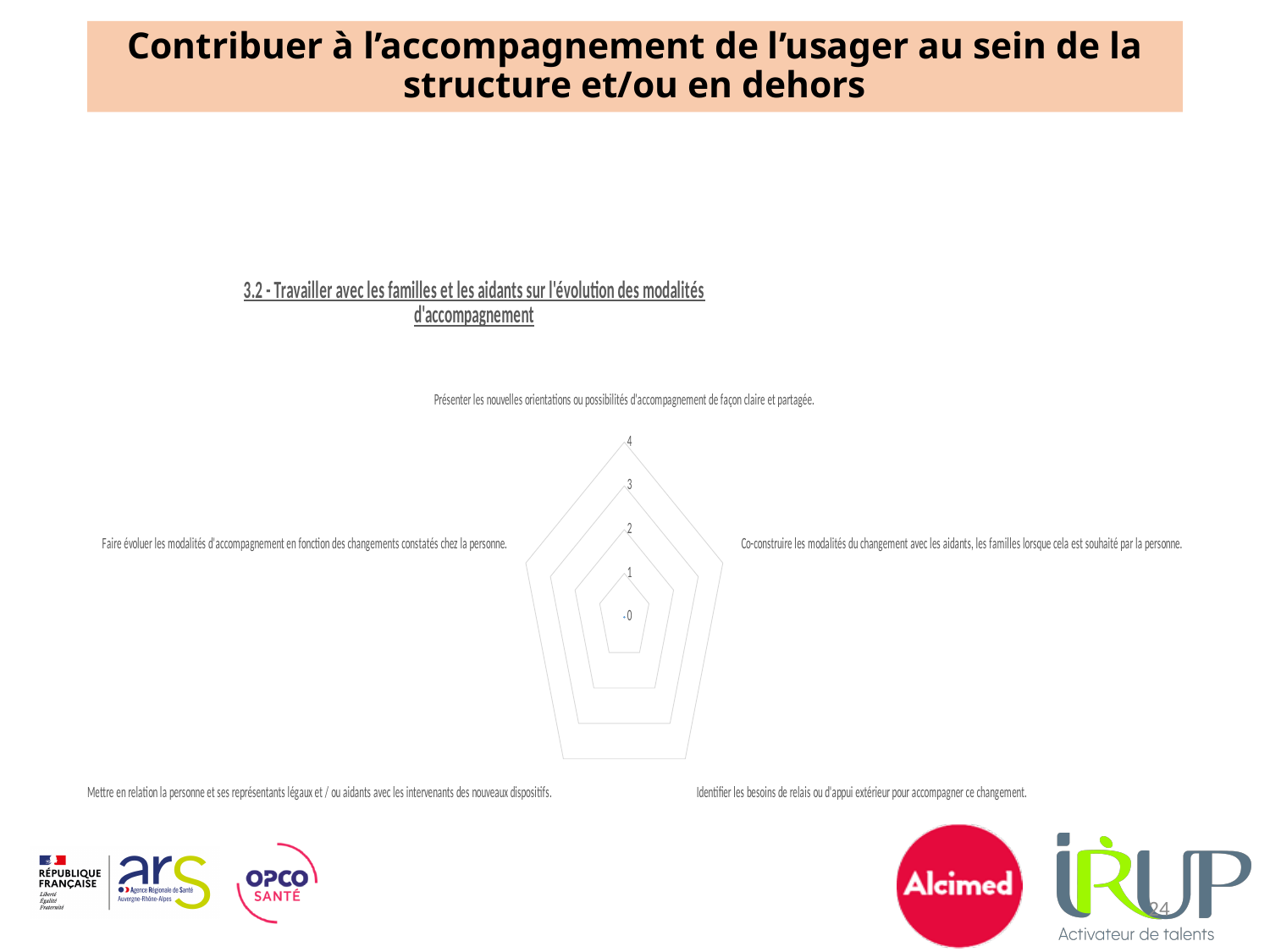
How many categories (axes) does the radar chart have? 5 What is the title of the radar chart? 3.2 - Travailler avec les familles et les aidants sur l'évolution des modalités d'accompagnement What is the highest value shown on the radar chart's scale? 4 Which category label appears at the bottom right of the radar chart? Identifier les besoins de relais ou d'appui extérieur pour accompagner ce changement. What kind of chart is shown on the slide? Radar chart Which category label appears at the top of the radar chart? Présenter les nouvelles orientations ou possibilités d'accompagnement de façon claire et partagée.